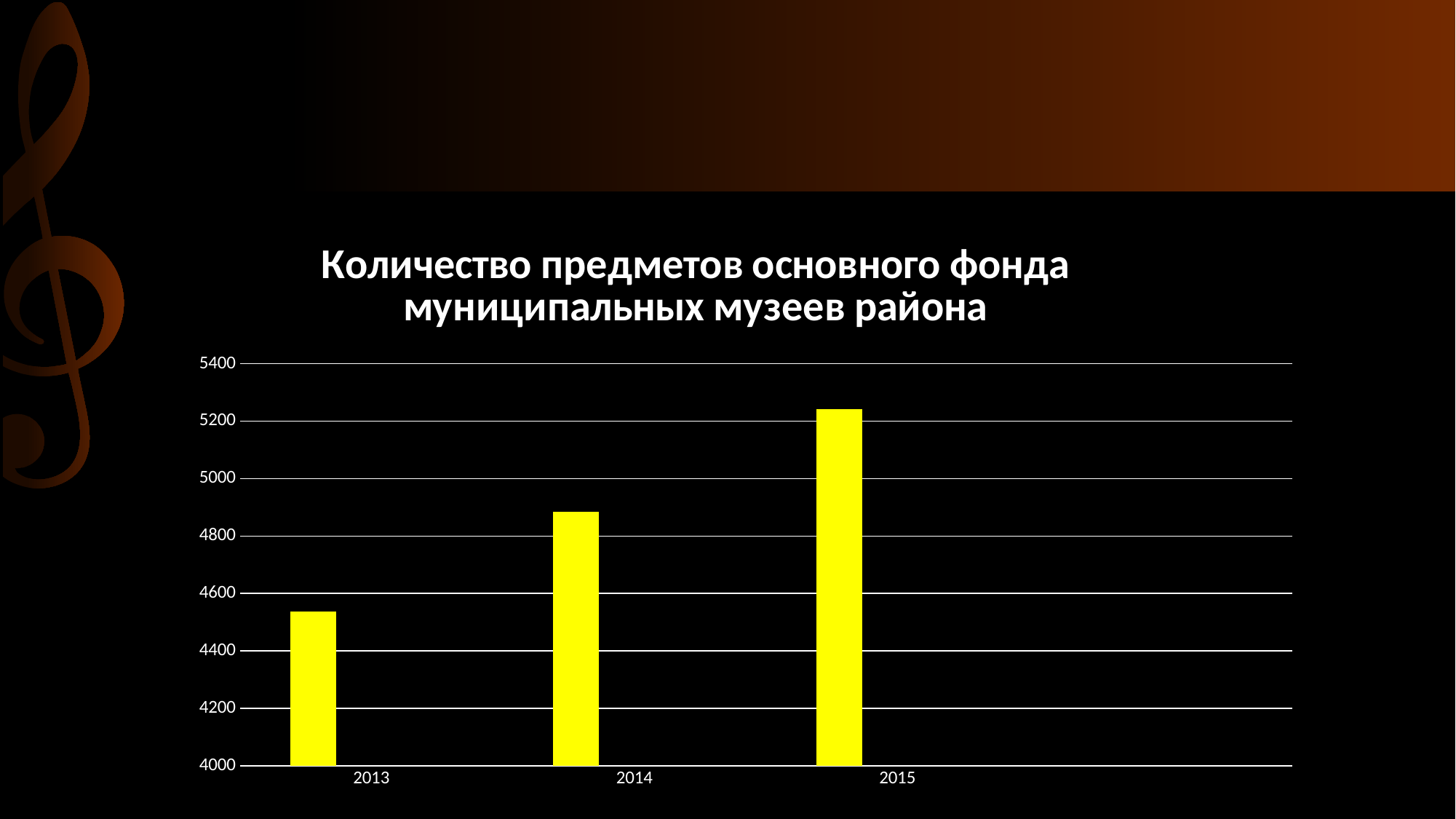
Is the value for 2015 greater or less than 5200? greater Is the value for 2014 greater or less than 4800? greater Do the values rise or fall from 2013 to 2015? rise Which year has the lowest number of items in the main fund? 2013 What colour are the bars in the chart? yellow How many years are shown on the x axis of the chart? 3 Which year has a larger value, 2013 or 2014? 2014 Which year has a larger value, 2014 or 2015? 2015 What kind of chart is shown on the slide? bar chart Which year has the highest number of items in the main fund? 2015 Is the value for 2013 greater or less than 4600? less What is the title of the chart? Количество предметов основного фонда муниципальных музеев района